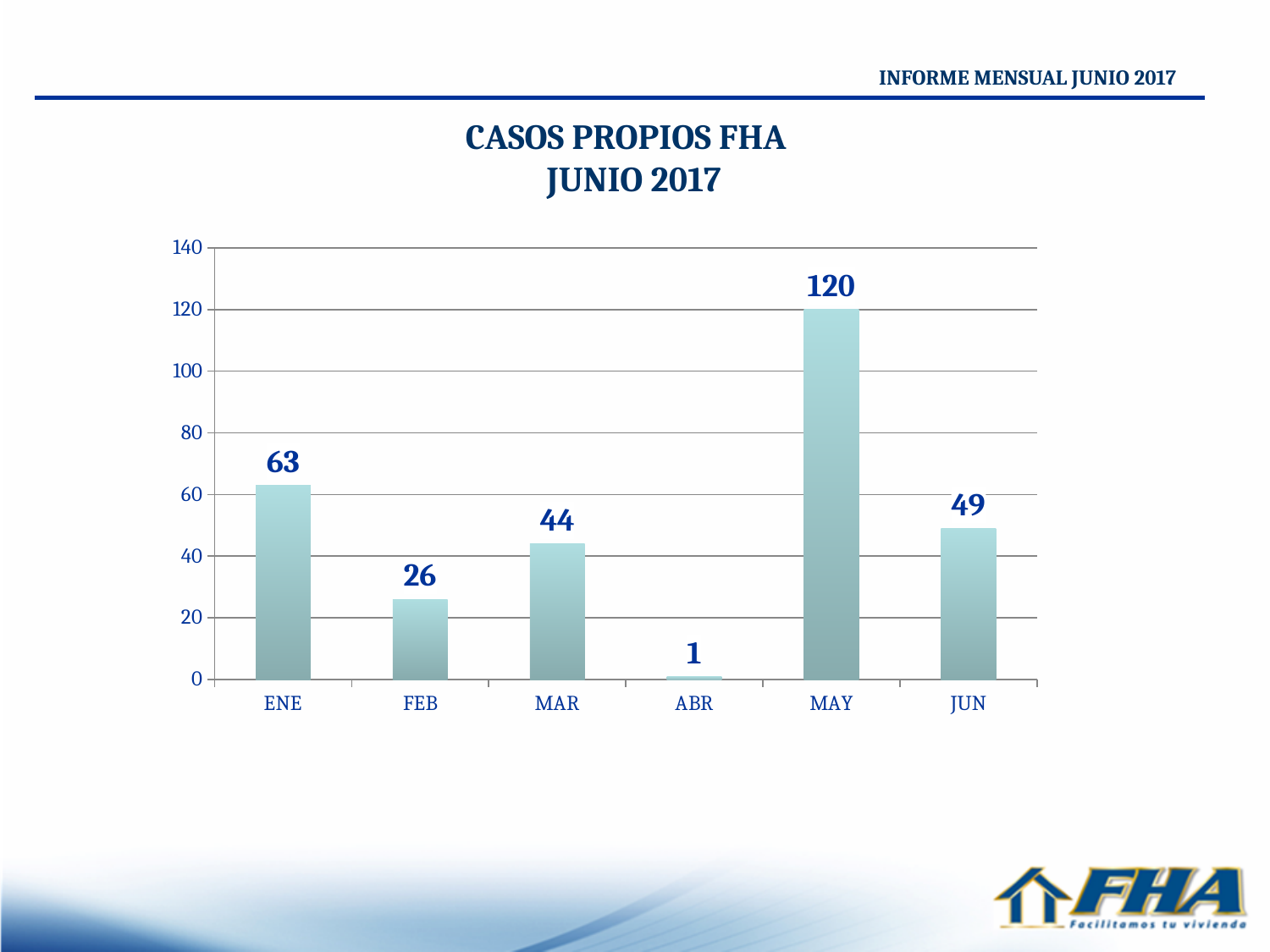
What is the title of the chart? CASOS PROPIOS FHA JUNIO 2017 Which is larger, the value for ENE or the value for JUN? ENE What is the value for MAY? 120 What is the difference between the values for ENE and FEB? 37 What is the value for ABR? 1 What kind of chart is shown on the slide? bar chart What is the difference between the values for MAY and JUN? 71 How many months are shown on the x axis? 6 Which month has the lowest value? ABR What is the value for FEB? 26 Is the value for MAR greater or less than 60? less Which month has the highest value? MAY